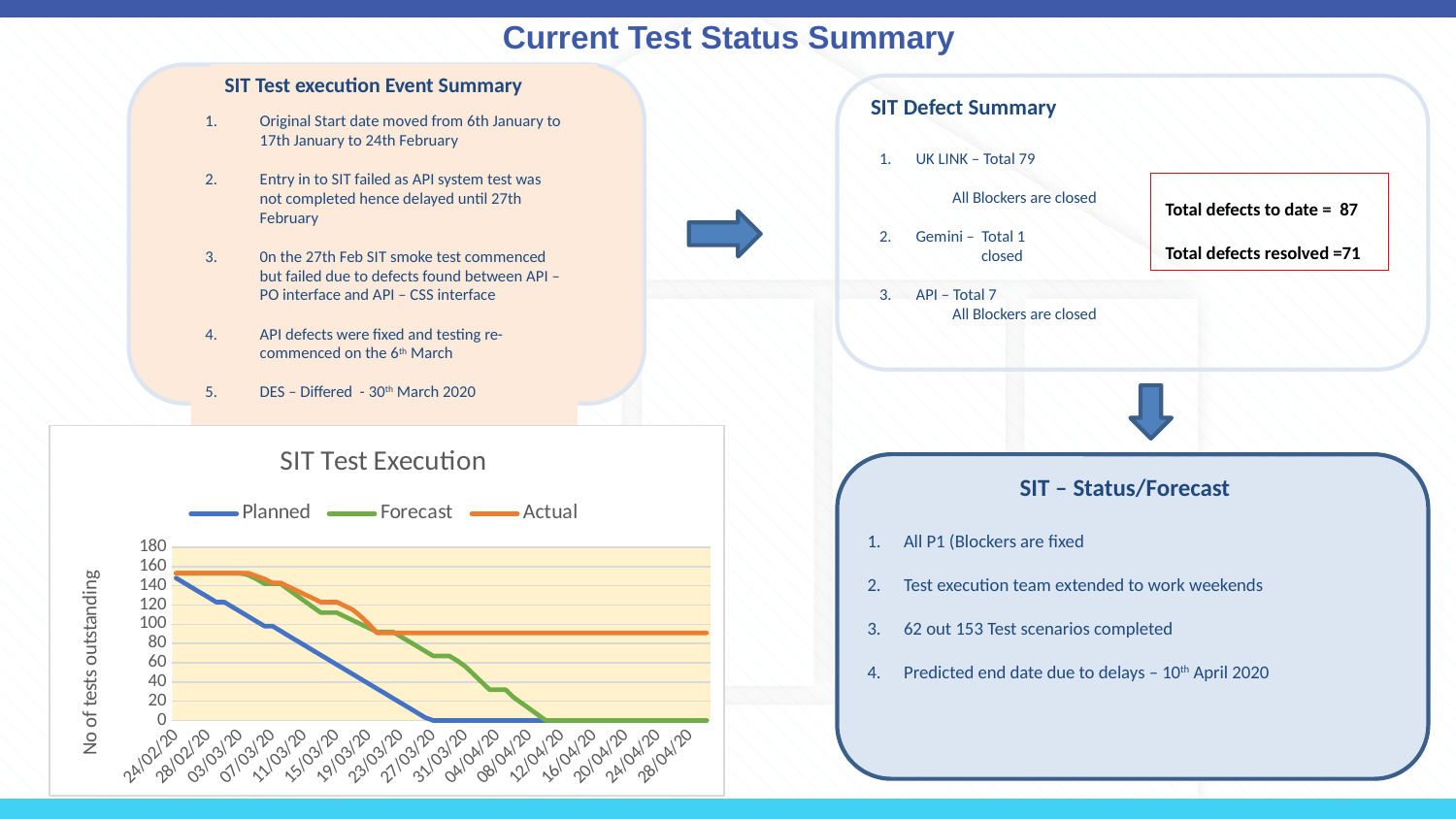
In the SIT Test Execution chart, which series has the highest value at 28/04/20? Actual In the SIT Test Execution chart, is the Actual value at 28/04/20 greater or less than 100? less What kind of chart is the SIT Test Execution chart? line chart In the SIT Test Execution chart, is the Planned value at 11/03/20 greater or less than 100? less How many series does the legend of the SIT Test Execution chart list? 3 What is the y-axis title of the SIT Test Execution chart? No of tests outstanding What are the series names shown in the legend of the SIT Test Execution chart? Planned, Forecast, Actual How many date labels are shown on the x axis of the SIT Test Execution chart? 17 In the SIT Test Execution chart, what is the Planned value at 28/04/20? 0 In the SIT Test Execution chart, what is the Forecast value at 28/04/20? 0 In the SIT Test Execution chart, is the Actual value at 28/04/20 greater or less than 80? greater Does the Planned series in the SIT Test Execution chart rise or fall along the x axis? fall